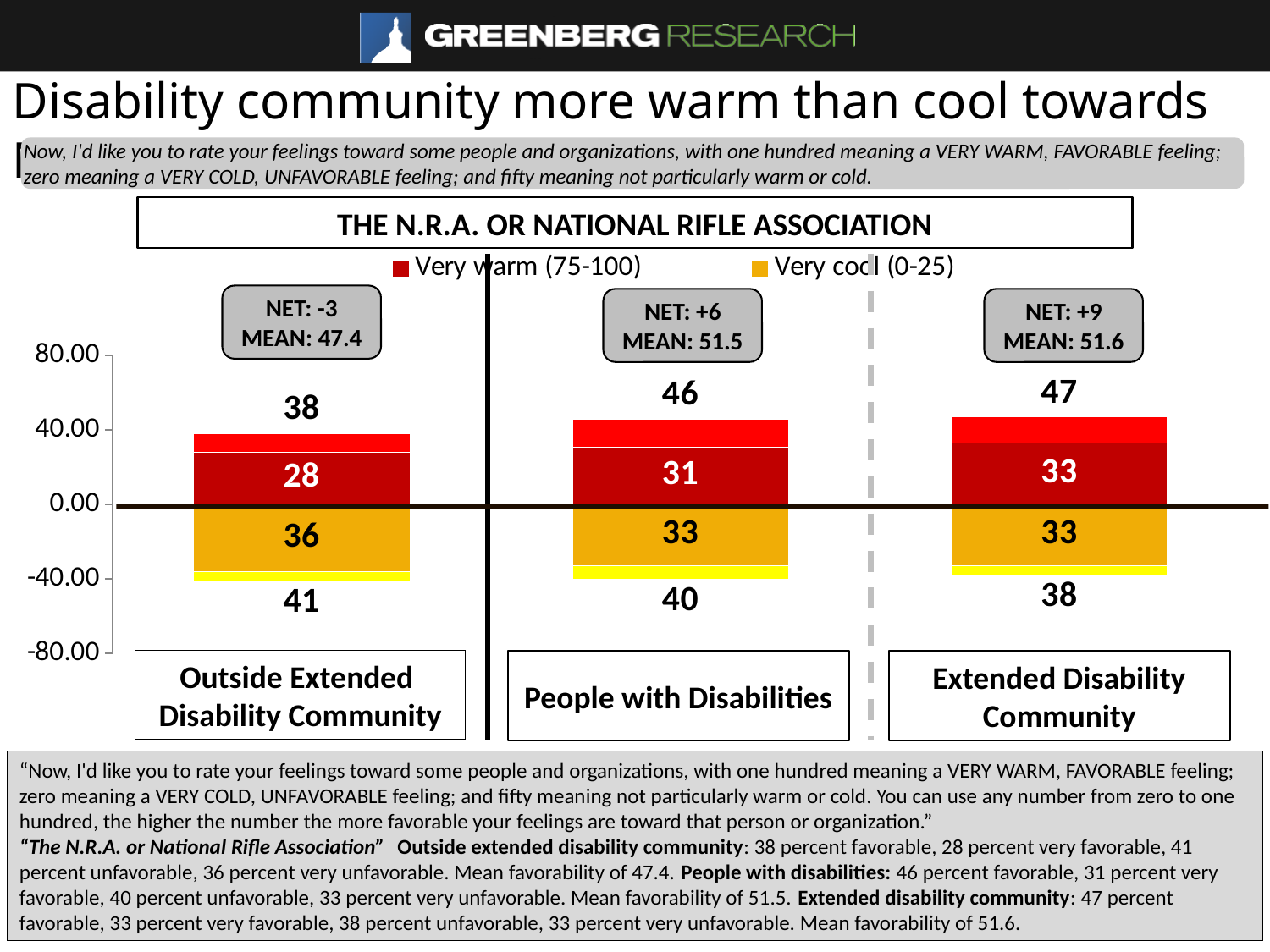
Which category has the highest 'Very warm (75-100)' value? Extended Disability Community What kind of chart is shown on the slide? bar chart What is the difference between the 'Very warm (75-100)' values for Extended Disability Community and Outside Extended Disability Community? 5 What is the 'Very cool (0-25)' value for Outside Extended Disability Community? 36 What is the total favorable value labelled above the bar for Extended Disability Community? 47 What MEAN value is shown in the box above the People with Disabilities bar? 51.5 What is the 'Very warm (75-100)' value for People with Disabilities? 31 Which is larger: the 'Very cool (0-25)' value for Outside Extended Disability Community or for People with Disabilities? Outside Extended Disability Community How many series does the chart legend list? 2 What is the title shown above the chart? THE N.R.A. OR NATIONAL RIFLE ASSOCIATION How many categories are shown along the x axis of the chart? 3 Which category has the lowest total favorable value labelled above its bar? Outside Extended Disability Community